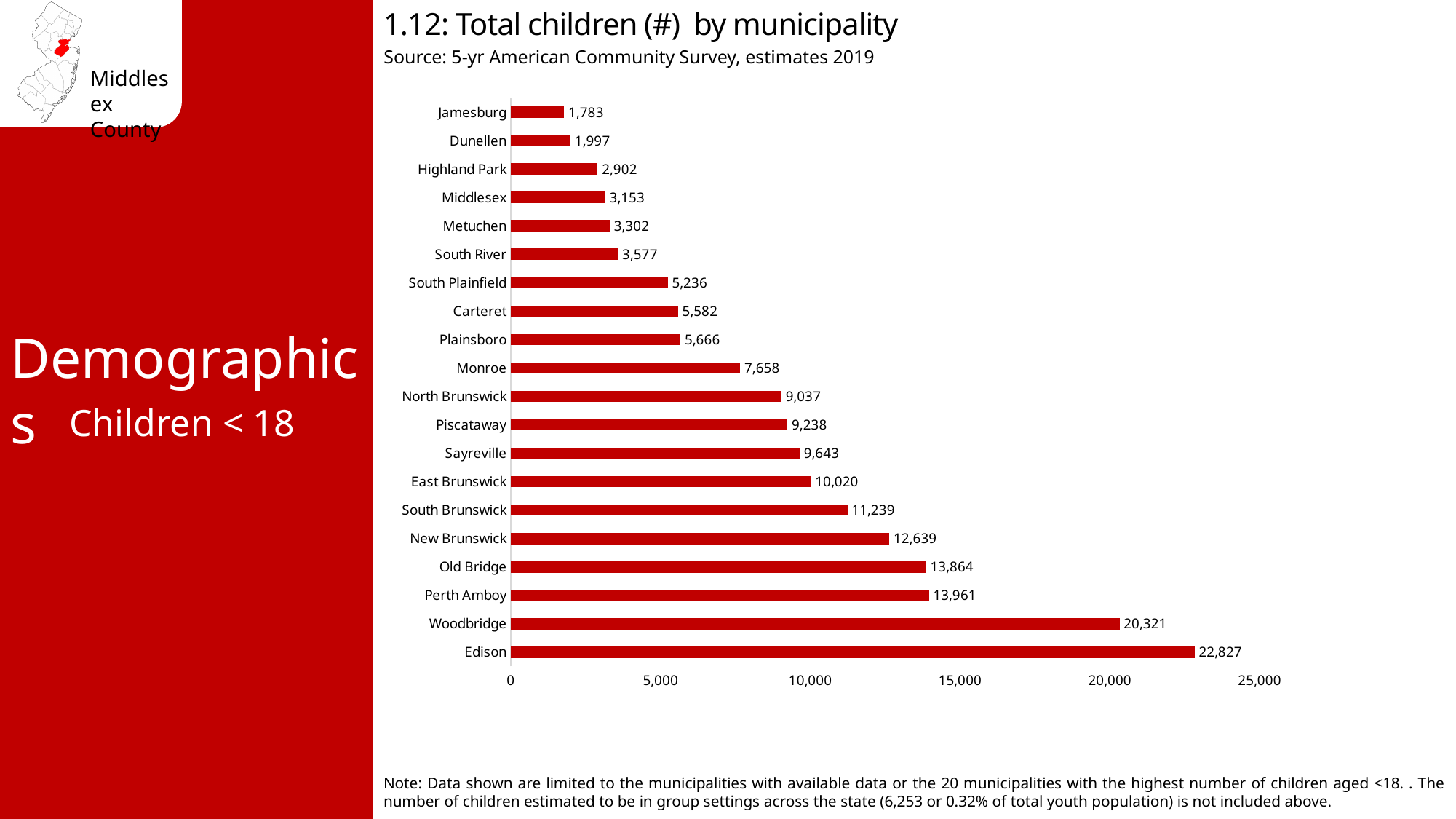
What is the total number of children in Edison? 22,827 What is the source of the data shown in the chart? 5-yr American Community Survey, estimates 2019 What is the total number of children in Metuchen? 3,302 What kind of chart is shown on the slide? bar chart What is the total number of children in New Brunswick? 12,639 Which has more children, South Brunswick or Sayreville? South Brunswick Which municipality has the lowest number of children? Jamesburg Is the value for Woodbridge greater or less than 20,000? greater What is the difference in the number of children between Old Bridge and Monroe? 6,206 Which municipality has the highest number of children? Edison How many municipalities are shown in the chart? 20 What is the difference in the number of children between Edison and Woodbridge? 2,506